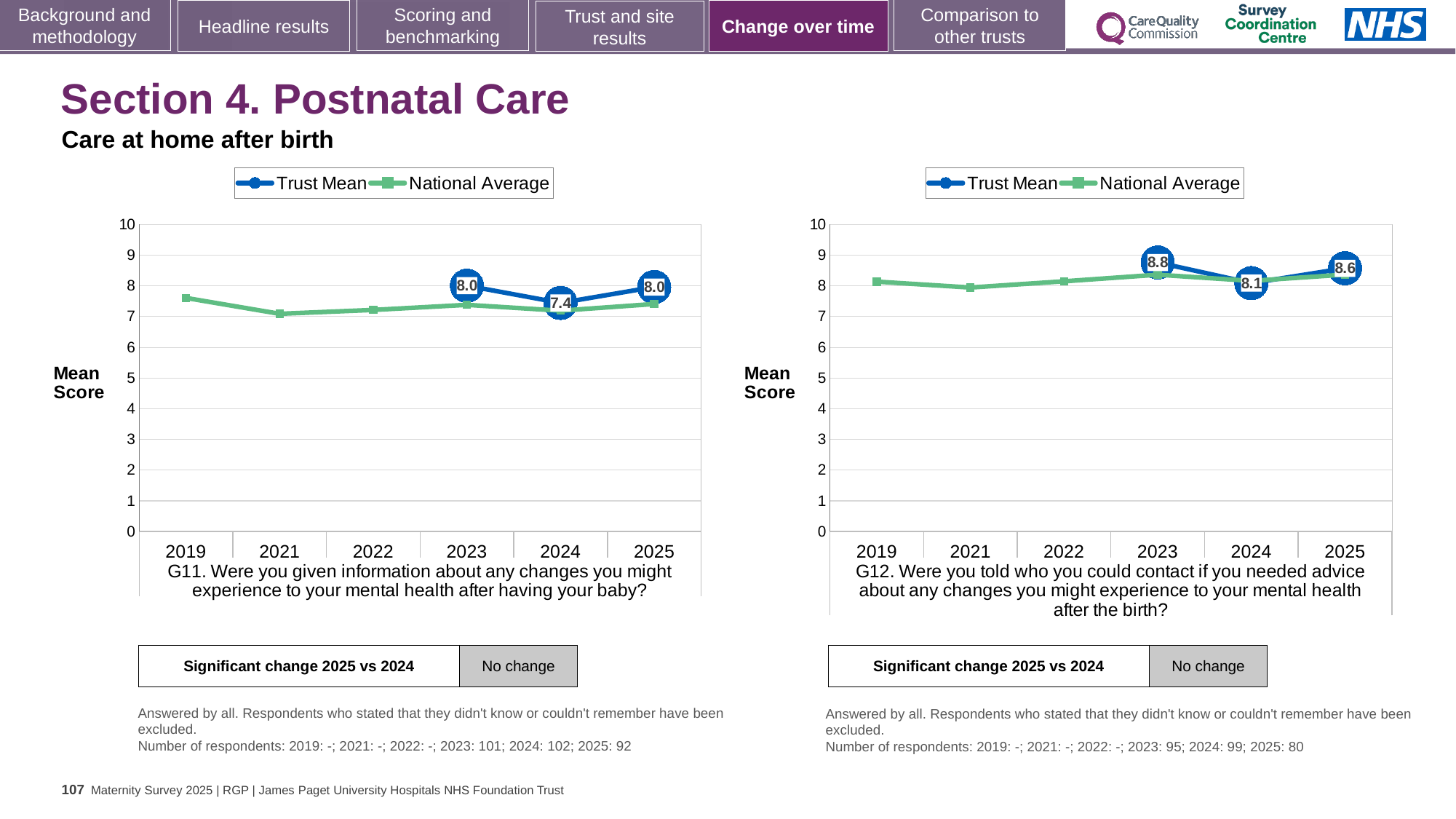
In the G12 chart on the right, what is the difference between the Trust Mean in 2023 and in 2024? 0.7 In the G12 chart on the right, what is the Trust Mean for 2024? 8.1 In the G12 chart on the right, which year has the lowest Trust Mean? 2024 In the G11 chart on the left, what is the difference between the Trust Mean in 2023 and in 2024? 0.6 How many years are shown on the x axis of the G12 chart on the right? 6 In the G11 chart on the left, what is the Trust Mean for 2024? 7.4 In the G11 chart on the left, is the Trust Mean higher in 2023 or in 2024? 2023 How many series does the legend of the G11 chart on the left list? 2 In the G12 chart on the right, which year has the highest Trust Mean? 2023 In the G12 chart on the right, what is the Trust Mean for 2023? 8.8 In the G11 chart on the left, what is the Trust Mean for 2025? 8.0 In the G11 chart on the left, is the National Average for 2019 greater or less than 7? greater